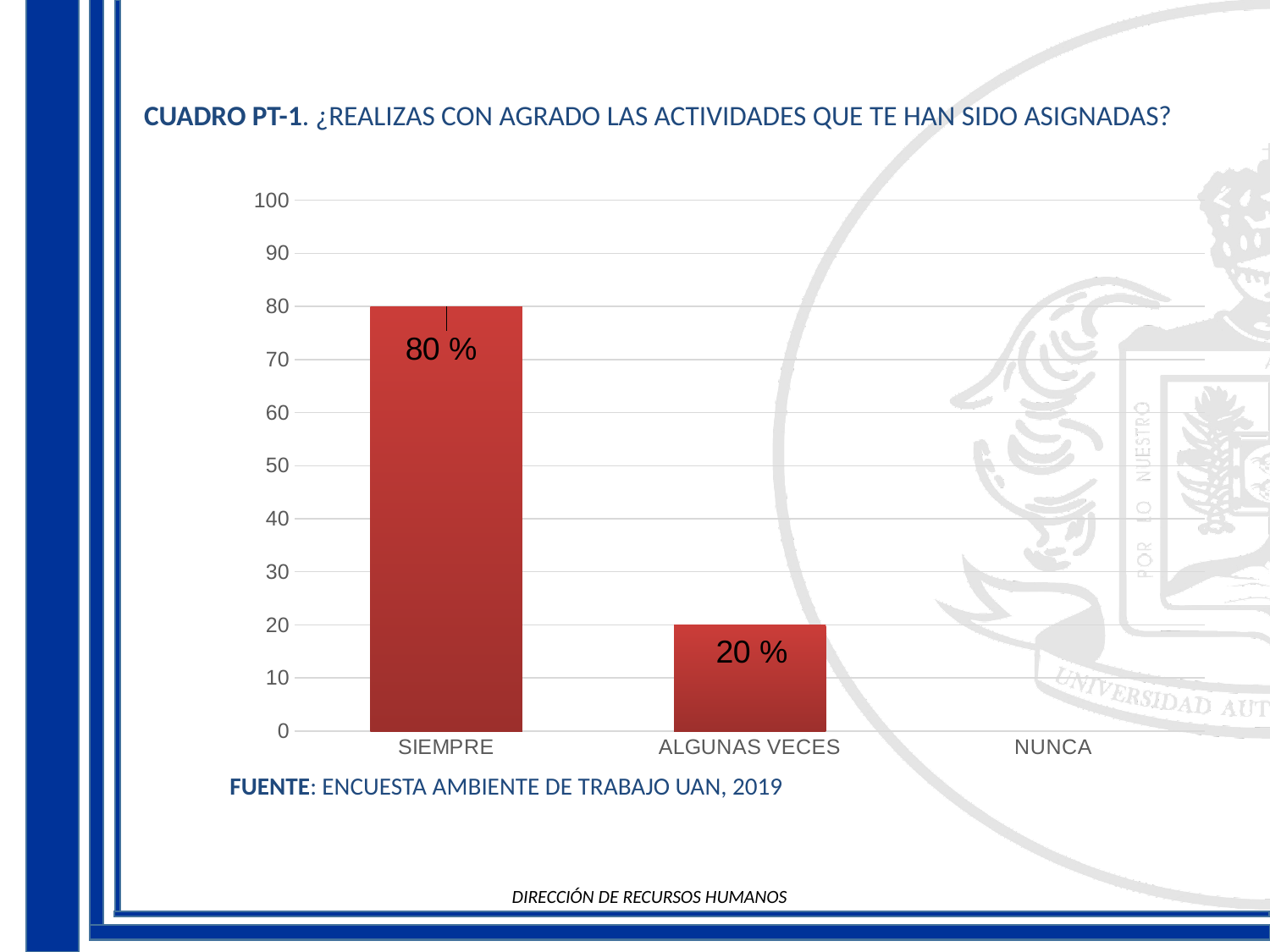
Do the values rise or fall from SIEMPRE to ALGUNAS VECES? fall Which is larger, the value for SIEMPRE or the value for ALGUNAS VECES? SIEMPRE What is the difference between the values for SIEMPRE and ALGUNAS VECES? 60 % Is the value for SIEMPRE greater or less than 50? greater What is the maximum value shown on the y axis? 100 Is the value for ALGUNAS VECES greater or less than 30? less Which category has the highest value? SIEMPRE What is the value for SIEMPRE? 80 % How many categories are shown on the x axis? 3 What source is cited below the chart? ENCUESTA AMBIENTE DE TRABAJO UAN, 2019 What kind of chart is shown on the slide? bar chart What is the value for ALGUNAS VECES? 20 %